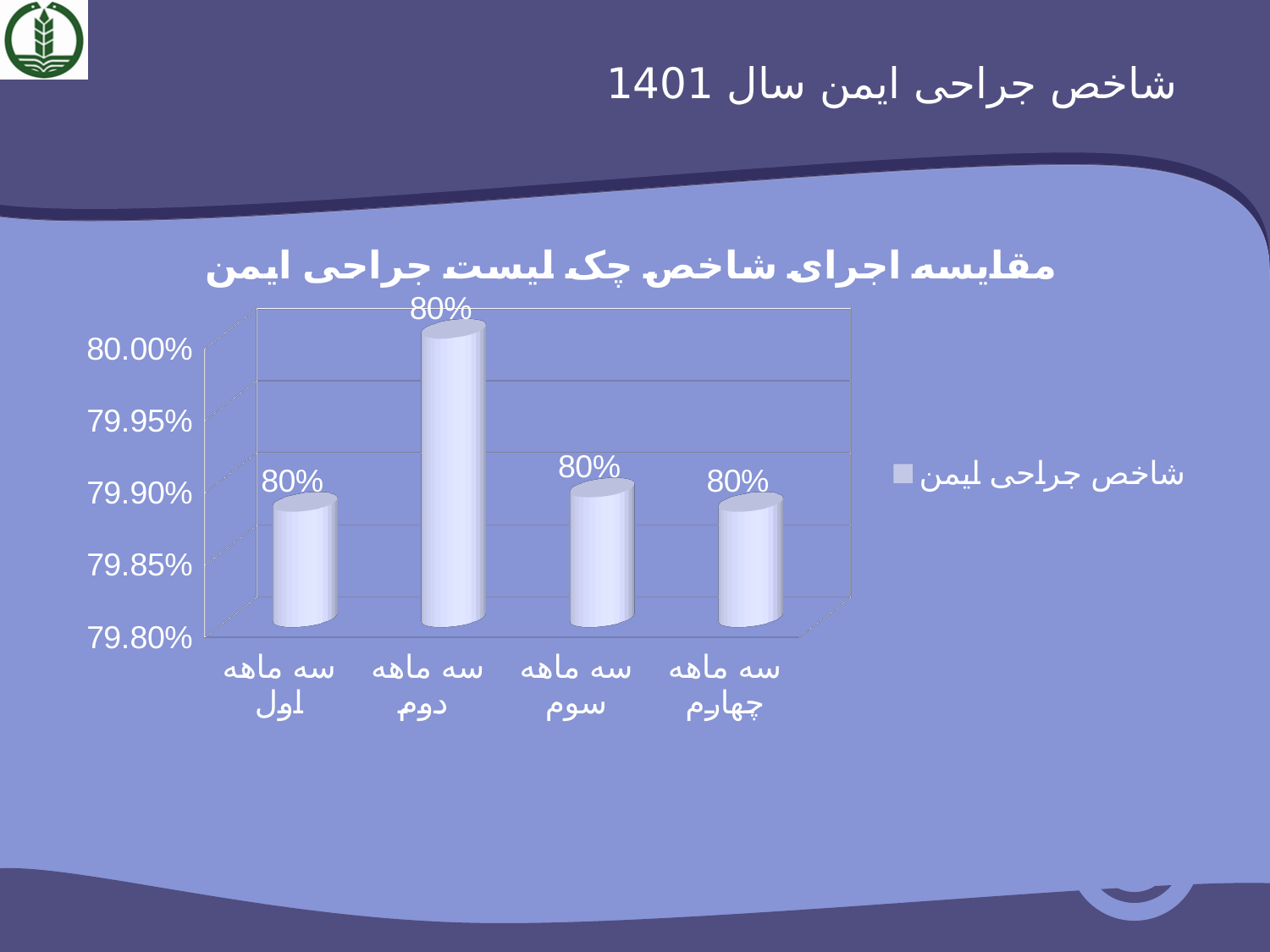
Which bar is taller, سه ماهه دوم or سه ماهه سوم? سه ماهه دوم What is the title of the chart? مقایسه اجرای شاخص چک لیست جراحی ایمن Which category has the tallest bar? سه ماهه دوم Is the value for سه ماهه دوم greater or less than 79.95%? greater What series name appears in the legend? شاخص جراحی ایمن How many series does the legend list? 1 What is the data label shown for سه ماهه دوم? 80% What kind of chart is shown on the slide? bar chart Is the value for سه ماهه اول greater or less than 79.95%? less What is the data label shown for سه ماهه اول? 80% How many categories are plotted on the chart? 4 What is the data label shown for سه ماهه چهارم? 80%